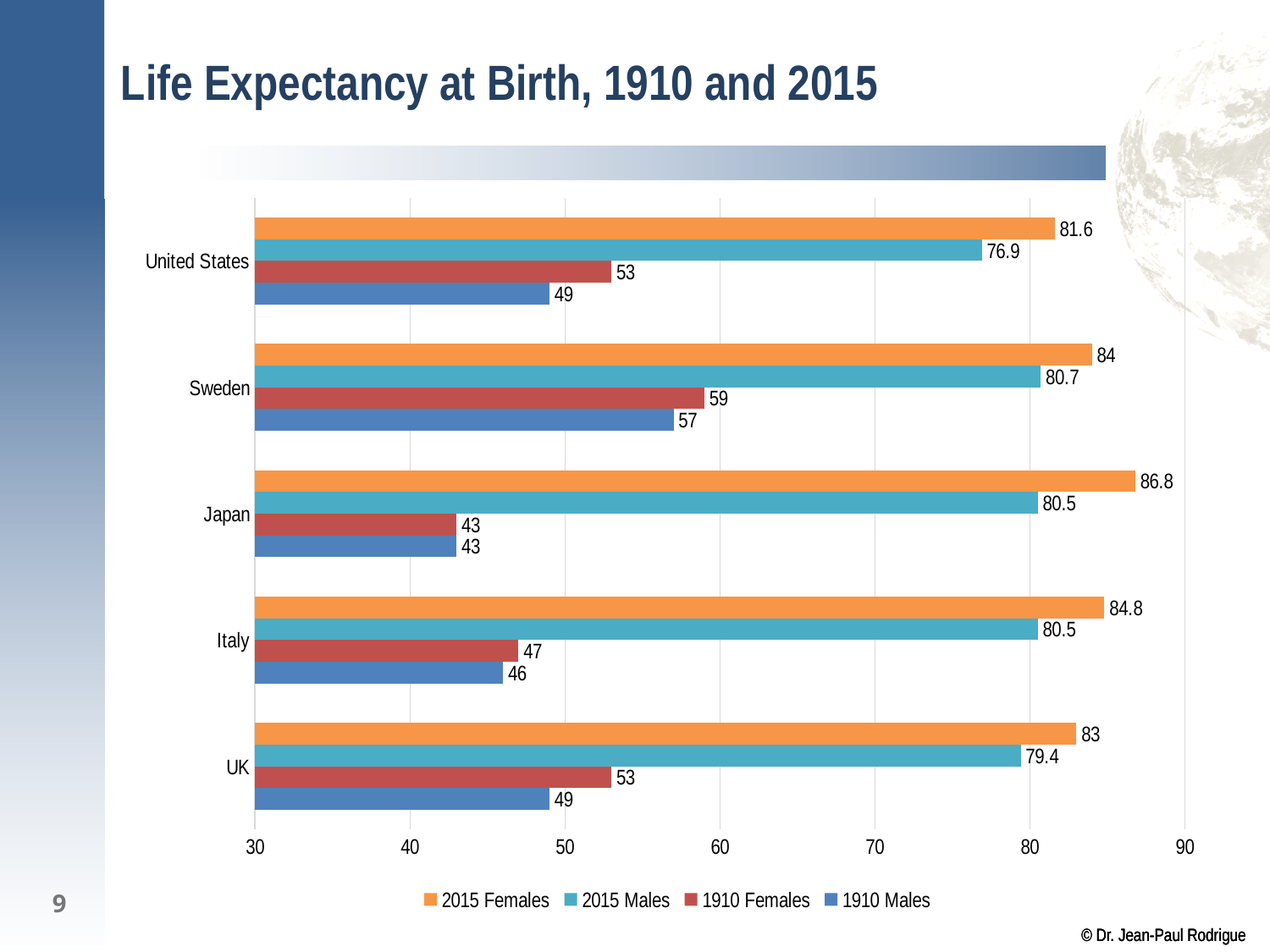
Which country has the lowest 1910 Females life expectancy? Japan What is the difference between the 2015 Females and 2015 Males life expectancy for Italy? 4.3 What is the 2015 Females life expectancy for Japan? 86.8 What is the title of the slide? Life Expectancy at Birth, 1910 and 2015 What is the 2015 Males life expectancy for the United States? 76.9 What kind of chart is shown on the slide? Bar chart How many countries are shown on the chart? 5 Which is larger, the 2015 Males value for Sweden or the 2015 Males value for the UK? Sweden Is the 1910 Females value for Sweden greater or less than 50? greater Which country has the highest 2015 Females life expectancy? Japan How many series does the legend list? 4 What is the 1910 Males life expectancy for Sweden? 57